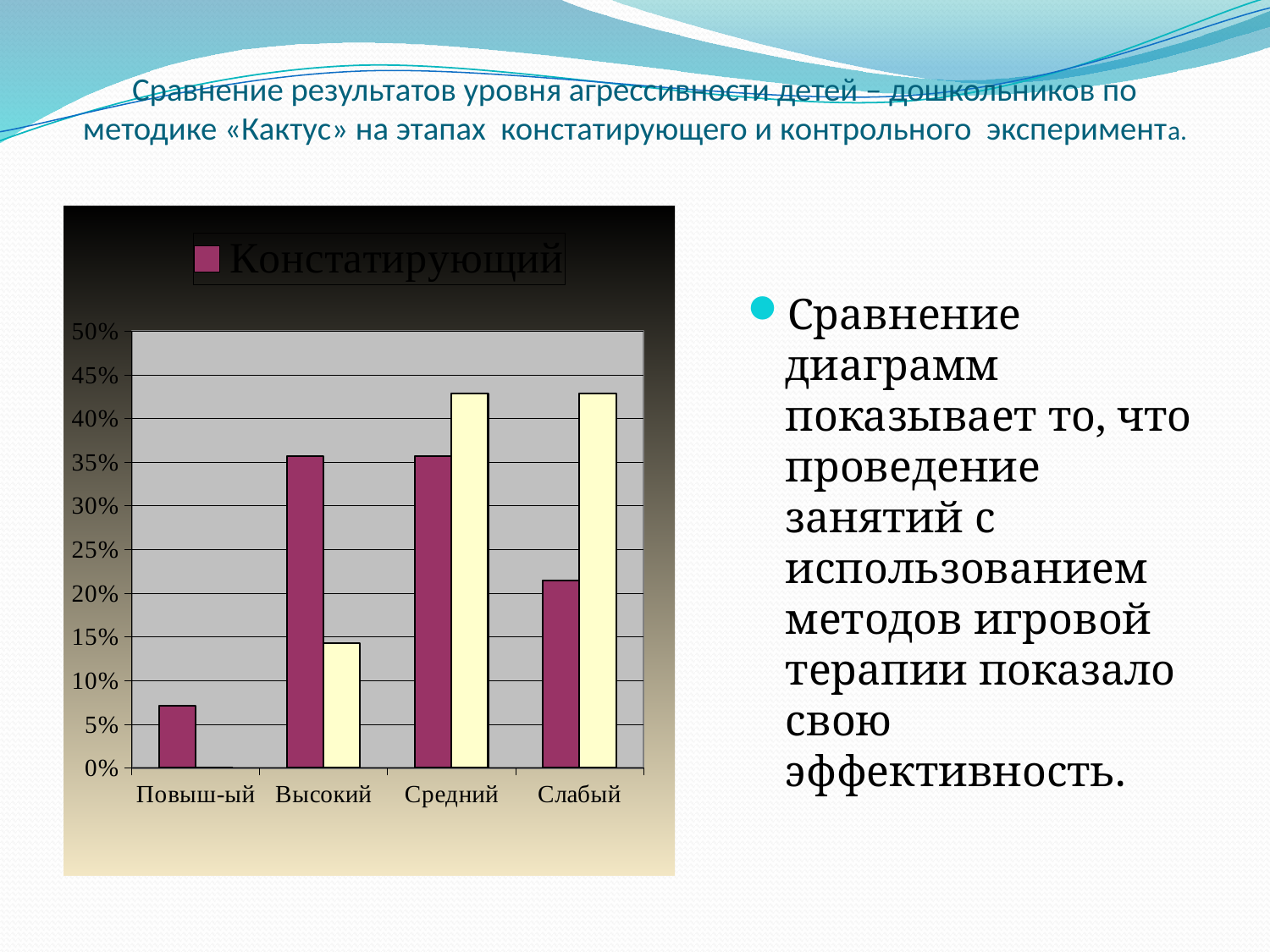
What colour are the bars for the Констатирующий series? magenta For Высокий, which is larger: the Констатирующий bar or the yellow bar? Констатирующий Which series name is shown in the chart's legend? Констатирующий For Средний, which is larger: the Констатирующий bar or the yellow bar? the yellow bar Is the Констатирующий value for Высокий greater or less than 30%? greater Is the Констатирующий value for Слабый greater or less than 25%? less Is the Констатирующий value for Повыш-ый greater or less than 10%? less How many categories are shown on the x axis of the chart? 4 Which category has the lowest Констатирующий value? Повыш-ый What kind of chart is shown on the slide? bar chart